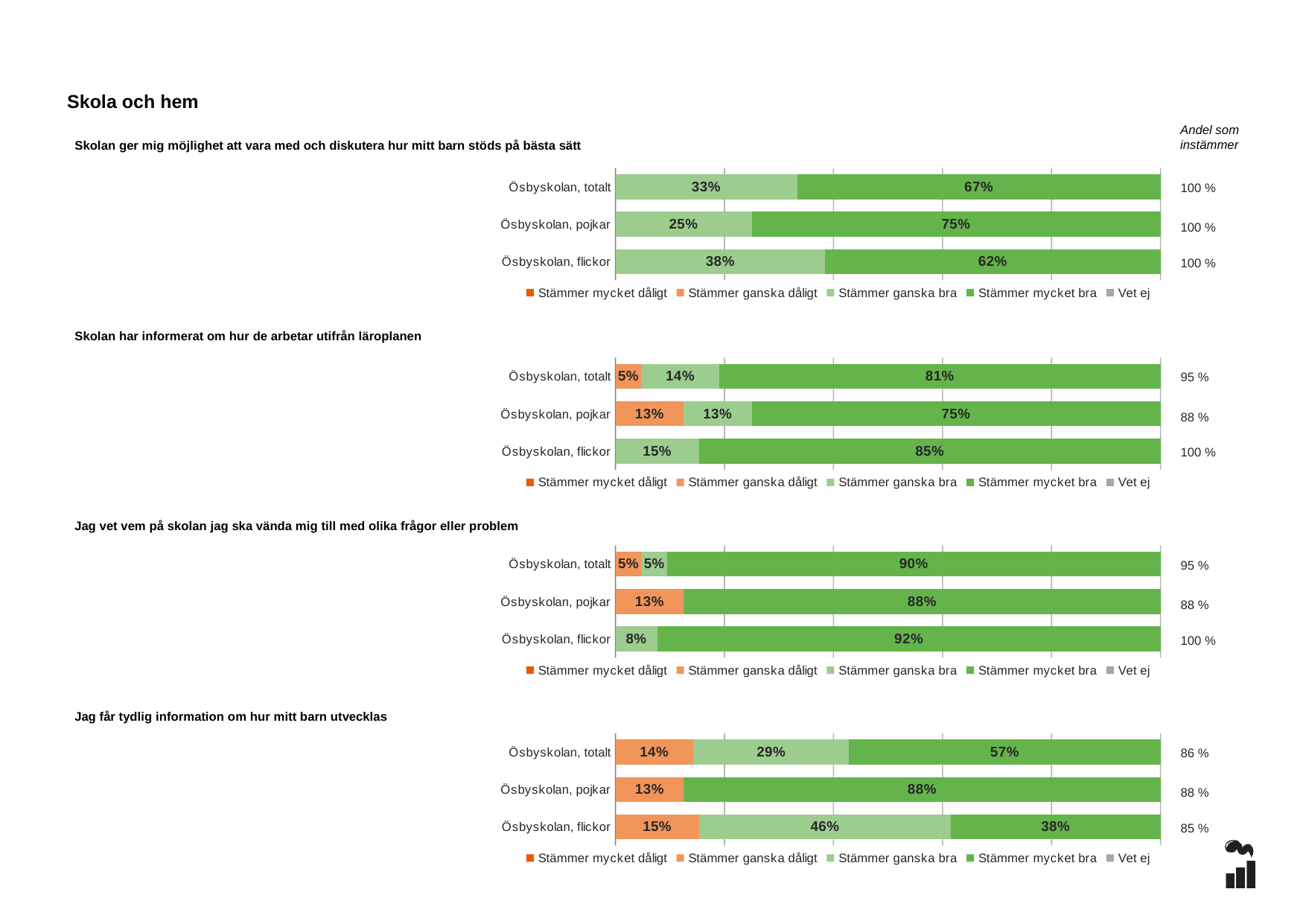
What kind of chart is 'Skolan ger mig möjlighet att vara med och diskutera hur mitt barn stöds på bästa sätt'? Stacked bar chart In the chart 'Jag vet vem på skolan jag ska vända mig till med olika frågor eller problem', which category has the lowest 'Stämmer mycket bra' value? Ösbyskolan, pojkar In the chart 'Jag får tydlig information om hur mitt barn utvecklas', what is the 'Stämmer ganska bra' value for Ösbyskolan, flickor? 46% In the chart 'Jag får tydlig information om hur mitt barn utvecklas', is the 'Stämmer mycket bra' value larger for Ösbyskolan, totalt or Ösbyskolan, pojkar? Ösbyskolan, pojkar In the chart 'Jag får tydlig information om hur mitt barn utvecklas', what is the total of the stacked bar for Ösbyskolan, totalt? 100% In the chart 'Skolan har informerat om hur de arbetar utifrån läroplanen', what is the difference between the 'Stämmer mycket bra' values for Ösbyskolan, flickor and Ösbyskolan, pojkar? 10% In the chart 'Skolan ger mig möjlighet att vara med och diskutera hur mitt barn stöds på bästa sätt', which category has the highest 'Stämmer ganska bra' value? Ösbyskolan, flickor How many categories are shown in the chart 'Skolan har informerat om hur de arbetar utifrån läroplanen'? 3 In the chart 'Skolan har informerat om hur de arbetar utifrån läroplanen', what is the 'Stämmer ganska dåligt' value for Ösbyskolan, totalt? 5% In the chart 'Jag vet vem på skolan jag ska vända mig till med olika frågor eller problem', what is the 'Stämmer mycket bra' value for Ösbyskolan, flickor? 92% How many series does the legend list for the chart 'Jag vet vem på skolan jag ska vända mig till med olika frågor eller problem'? 5 In the chart 'Skolan ger mig möjlighet att vara med och diskutera hur mitt barn stöds på bästa sätt', what is the 'Stämmer mycket bra' value for Ösbyskolan, pojkar? 75%